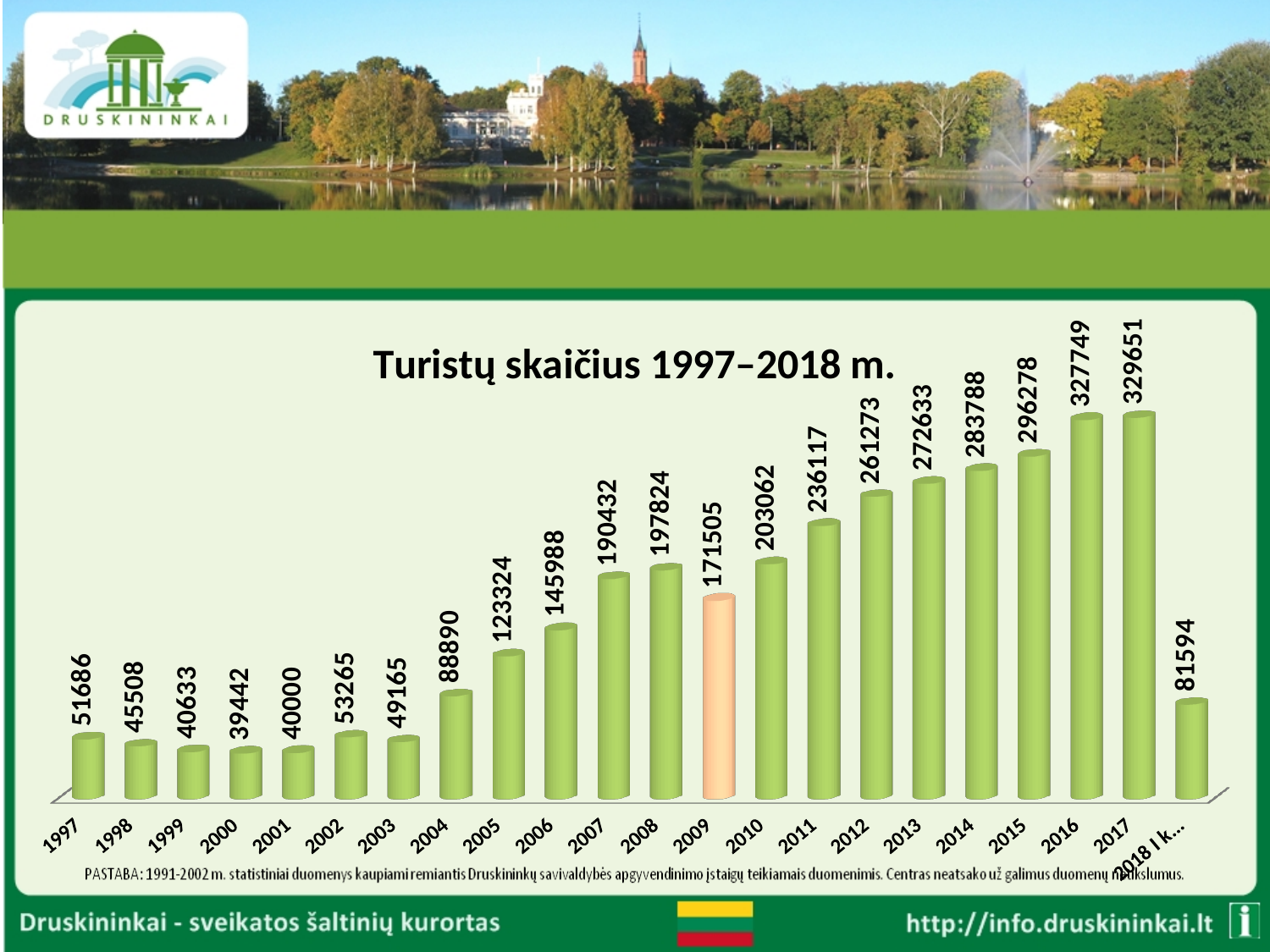
What is the value for 2009? 171505 Which year has the lowest value? 2000 Which bar is shown in a different colour from the others? 2009 Which is larger, the value for 2002 or the value for 2003? 2002 What kind of chart is shown on the slide? bar chart What is the value for 2015? 296278 What is the title of the chart? Turistų skaičius 1997–2018 m. What is the value for 2004? 88890 Which year has the highest value? 2017 How many bars are plotted in the chart? 22 What is the difference between the values for 2017 and 2016? 1902 What is the difference between the values for 2008 and 2009? 26319